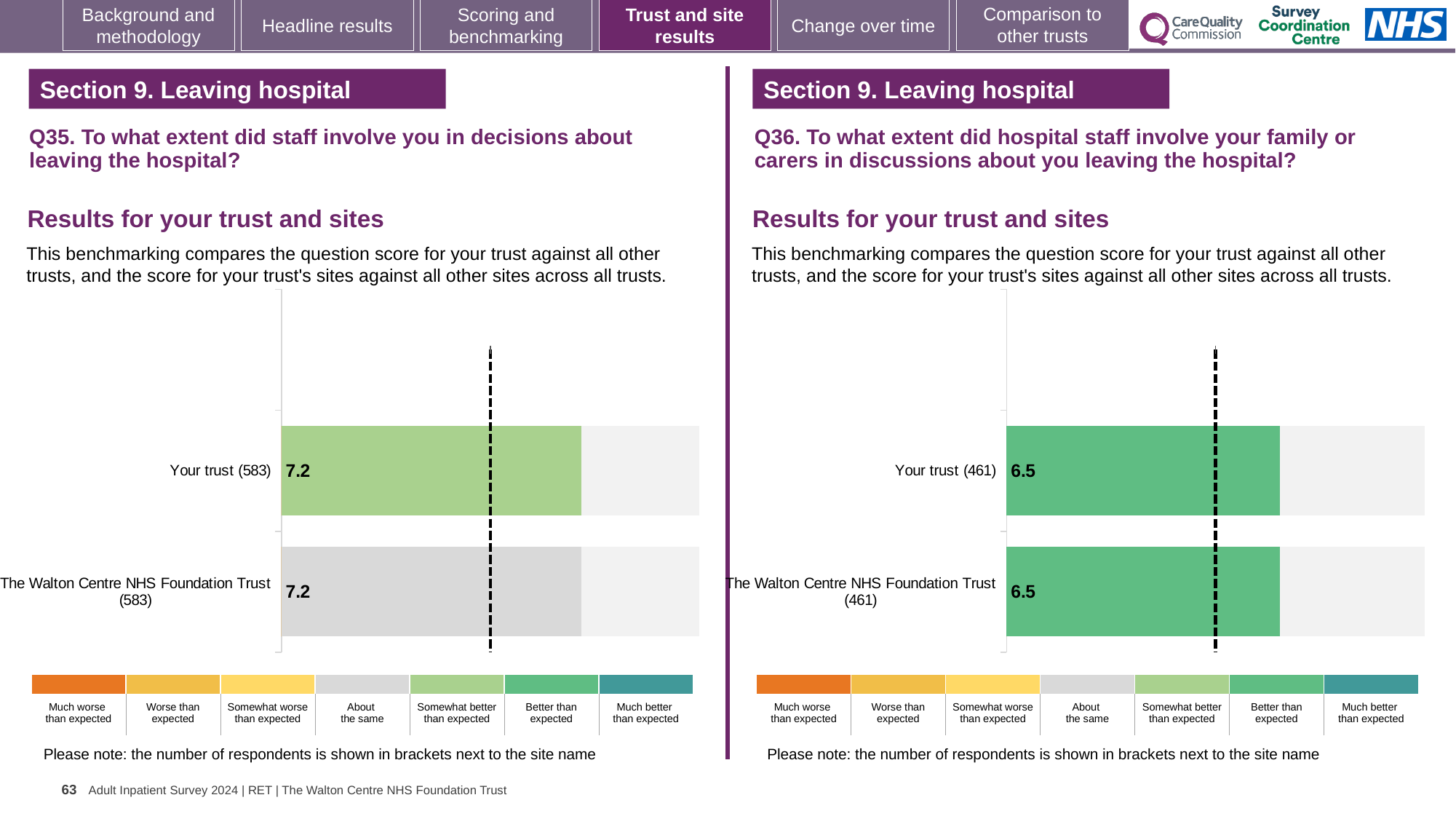
On the Q36 chart (right), which benchmark category does the colour of the Your trust bar correspond to in the key? Better than expected On the Q36 chart (right), what is the score for The Walton Centre NHS Foundation Trust (461)? 6.5 On the Q35 chart (left), how many respondents are shown in brackets for Your trust? 583 On the Q35 chart (left), what is the score for Your trust (583)? 7.2 How many bars are plotted on the Q35 chart (left)? 2 What type of chart is used on the Q35 chart (left)? Bar chart On the Q36 chart (right), what is the difference between the score for Your trust and the score for The Walton Centre NHS Foundation Trust? 0.0 On the Q36 chart (right), what is the score for Your trust (461)? 6.5 On the Q35 chart (left), what is the score for The Walton Centre NHS Foundation Trust (583)? 7.2 How many bars are plotted on the Q36 chart (right)? 2 On the Q35 chart (left), what is the difference between the score for Your trust and the score for The Walton Centre NHS Foundation Trust? 0.0 Is the score for Your trust on the Q35 chart (left) larger than the score for Your trust on the Q36 chart (right)? Yes